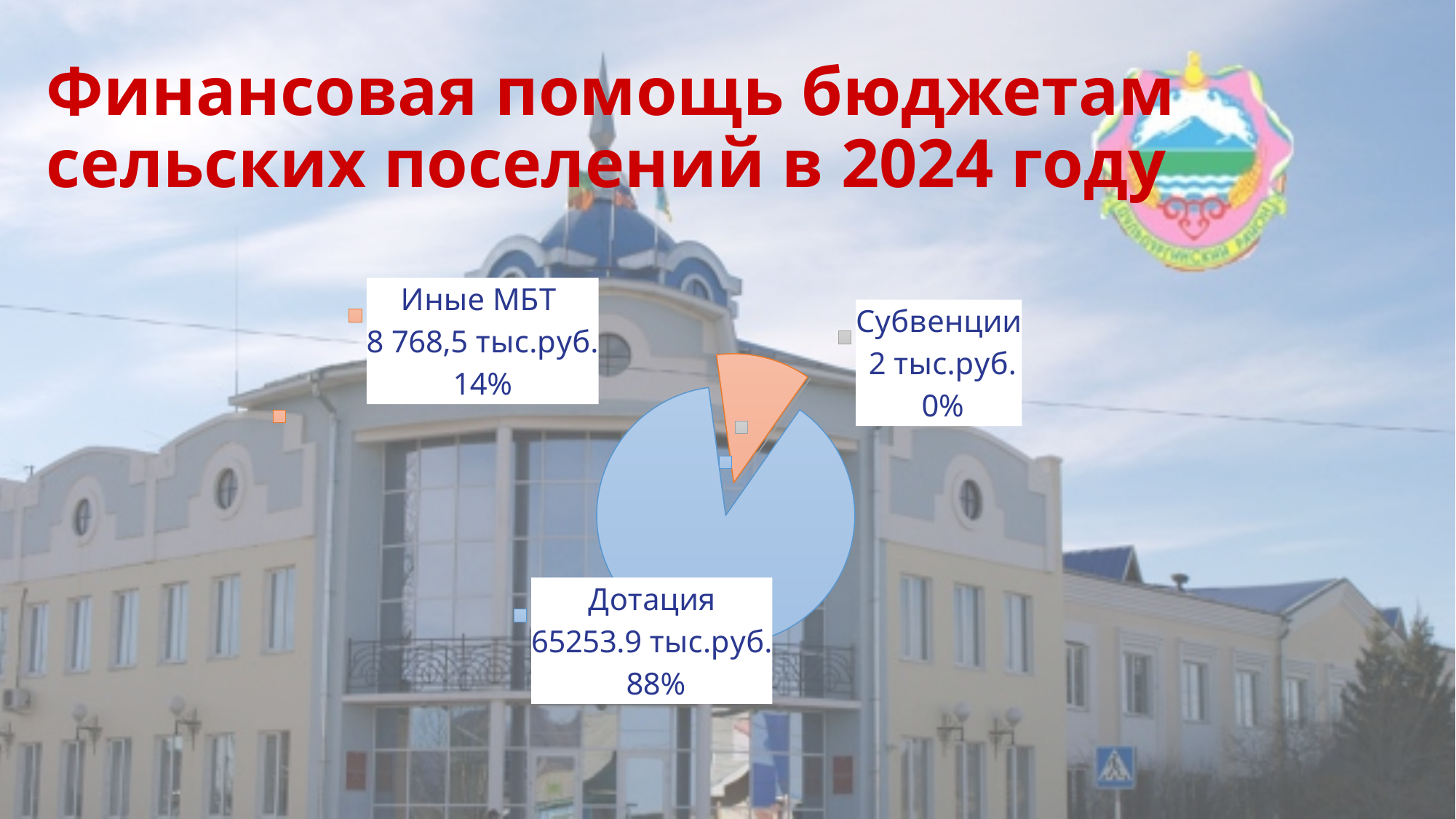
Which is larger, Иные МБТ or Субвенции? Иные МБТ How many slices does the pie chart have? 3 What is the value shown for Субвенции? 2 тыс.руб. What is the title of the slide containing the pie chart? Финансовая помощь бюджетам сельских поселений в 2024 году By how many percentage points does the share of Дотация exceed the share of Иные МБТ? 74% What kind of chart is shown on the slide? pie chart What share of the pie does Дотация represent? 88% What is the value shown for Дотация? 65253.9 тыс.руб. Which category has the largest slice of the pie? Дотация What share of the pie does Иные МБТ represent? 14% What is the value shown for Иные МБТ? 8 768,5 тыс.руб. Which category has the smallest slice of the pie? Субвенции